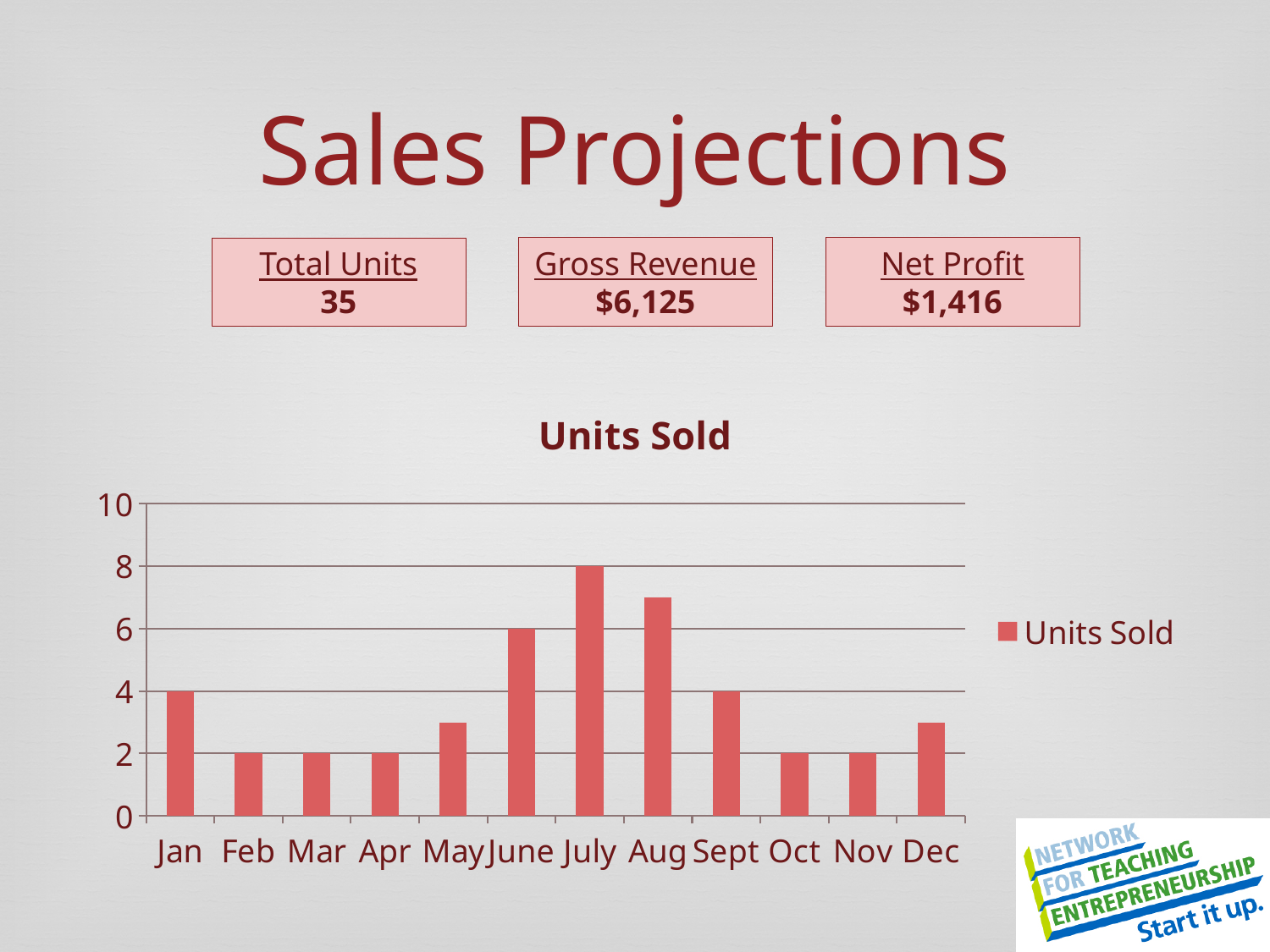
What is the title of the chart? Units Sold Is the value for Dec greater or less than 4? less Which is larger, the value for June or the value for Feb? June Is the value for Aug greater or less than 6? greater What type of chart is shown on the slide? bar chart What is the value for June? 6 Which month has the highest units sold? July What is the difference between the values for July and Sept? 4 What is the value for Jan? 4 How many months are shown on the x axis of the chart? 12 What is the value for July? 8 How many series does the legend list? 1